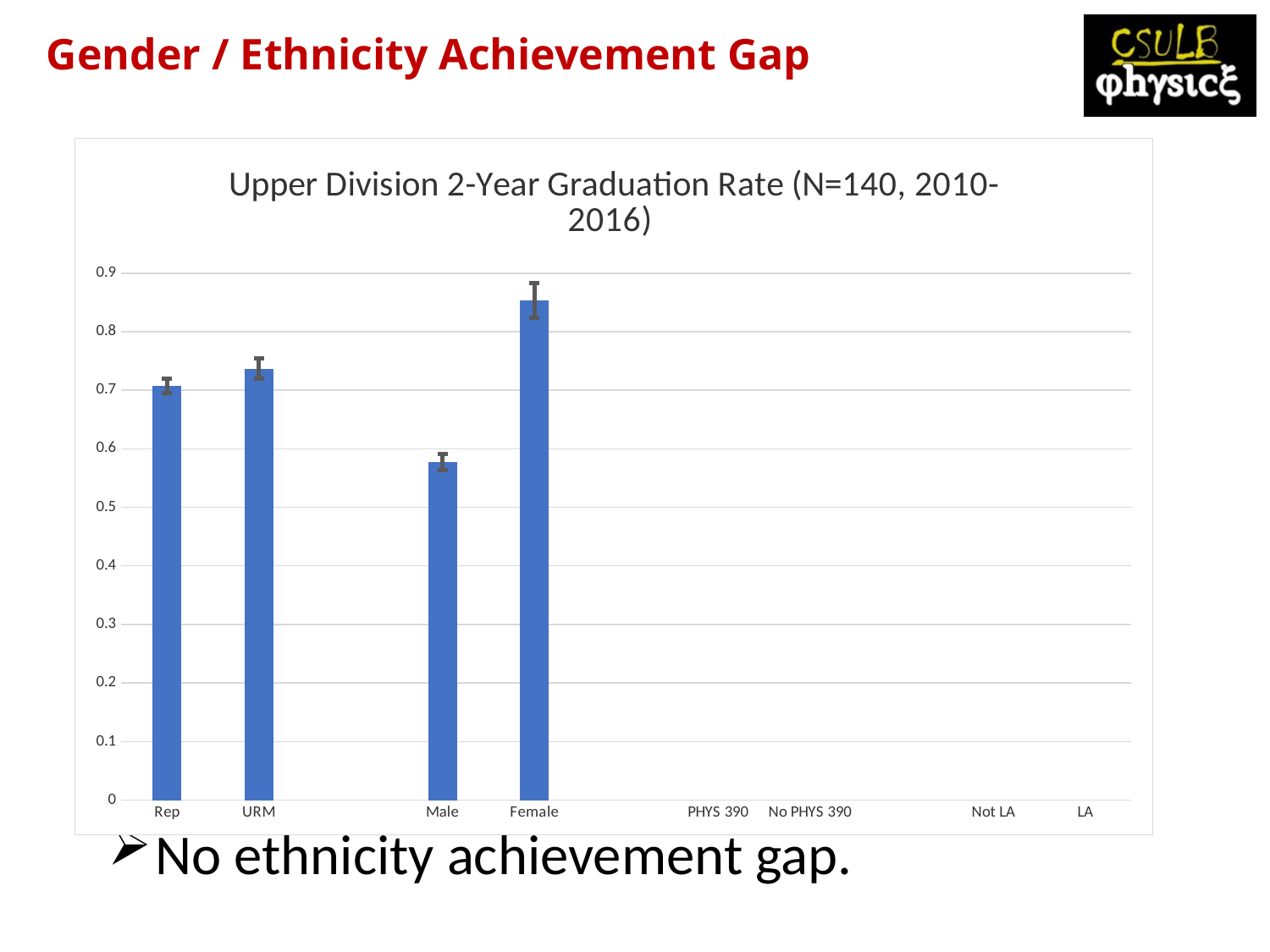
Is the value for Male greater or less than 0.6? less Which category has the highest graduation rate? Female Which has a higher graduation rate, Male or URM? URM Is the value for Female greater or less than 0.8? greater What kind of chart is shown on the slide? bar chart How many category labels are shown on the x axis? 8 What is the title of the chart? Upper Division 2-Year Graduation Rate (N=140, 2010-2016) Is the value for Rep greater or less than 0.8? less Which category has the lowest graduation rate among the plotted bars? Male Which has a higher graduation rate, Male or Female? Female How many bars are actually plotted in the chart? 4